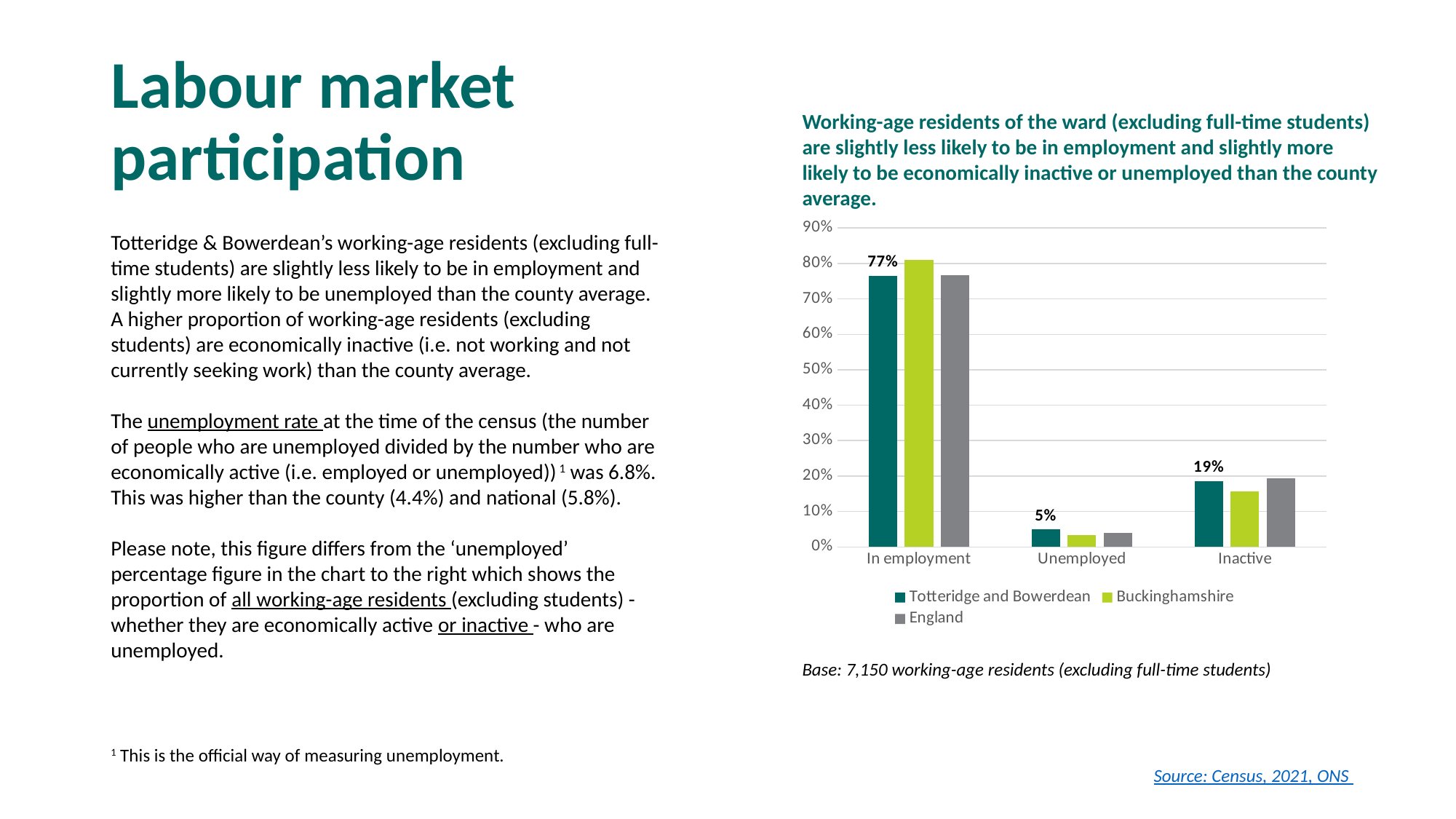
What is the difference between the Totteridge and Bowerdean values for In employment and Inactive? 58 percentage points How many categories are shown on the x axis of the chart? 3 In the In employment category, which is larger: Totteridge and Bowerdean or Buckinghamshire? Buckinghamshire What is the value for Totteridge and Bowerdean in the In employment category? 77% In the Inactive category, which is larger: Totteridge and Bowerdean or Buckinghamshire? Totteridge and Bowerdean How many series does the chart's legend list? 3 For Totteridge and Bowerdean, which category has the highest value? In employment Is the value for England in the In employment category greater or less than 70%? greater What is the value for Totteridge and Bowerdean in the Unemployed category? 5% For Totteridge and Bowerdean, which category has the lowest value? Unemployed What is the value for Totteridge and Bowerdean in the Inactive category? 19% Is the value for Buckinghamshire in the Inactive category greater or less than 20%? less